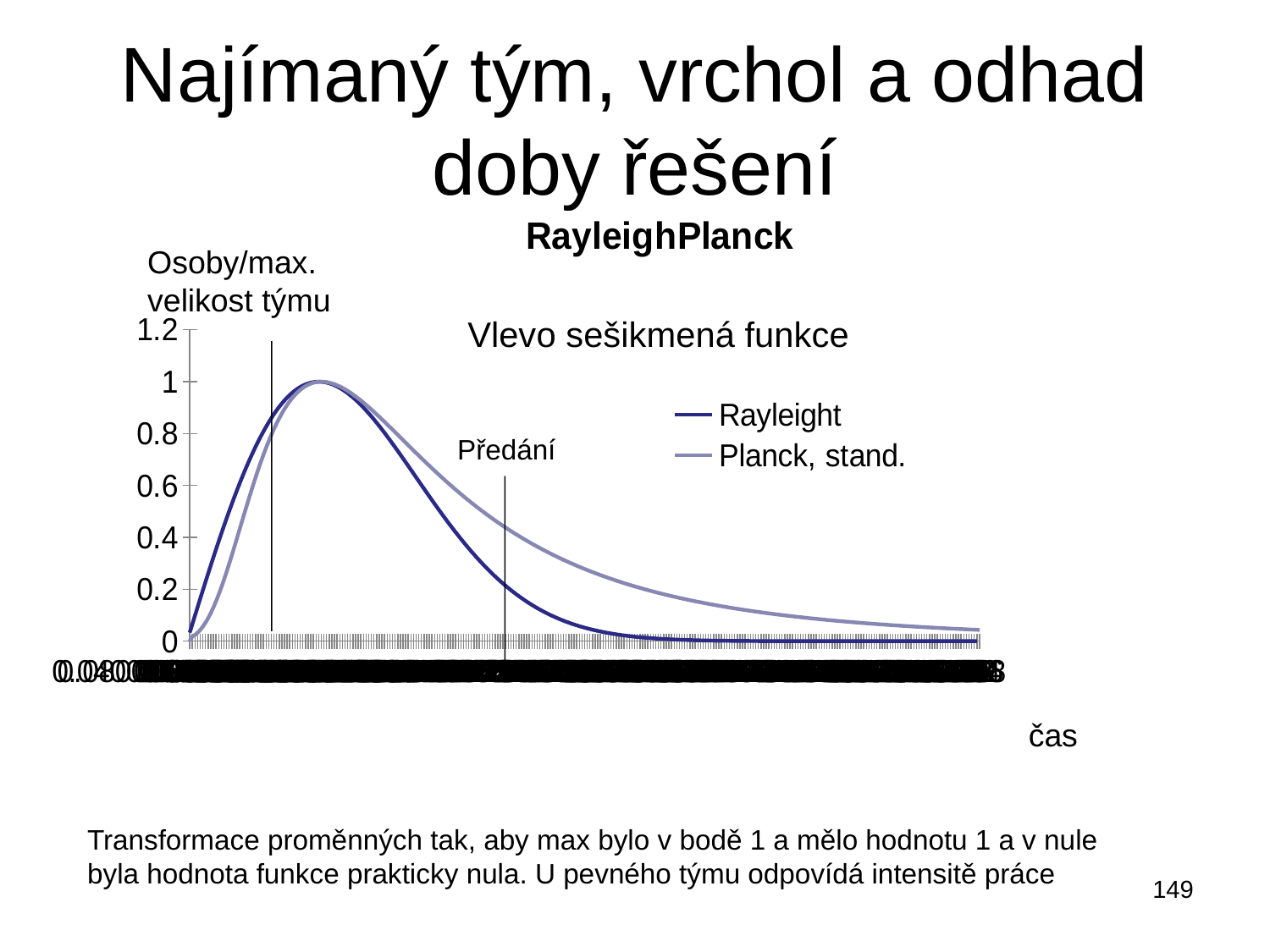
What kind of chart is shown on the slide? line chart What is the peak value reached by the Planck, stand. curve? 1 What are the two series named in the chart legend? Rayleight and Planck, stand. At the vertical line labelled Předání, is the value of the Planck, stand. curve greater or less than 0.2? greater At the right end of the x axis, which series has the higher value, Rayleight or Planck, stand.? Planck, stand. At the vertical line labelled Předání, which series has the higher value, Rayleight or Planck, stand.? Planck, stand. After reaching their peak, do the two curves rise or fall as time increases along the x axis? fall What is the peak value reached by the Rayleight curve? 1 What is the highest tick value shown on the y axis of the chart? 1.2 How many series does the chart legend list? 2 What is the title of the chart? RayleighPlanck At the vertical line labelled Předání, is the value of the Rayleight curve greater or less than 0.4? less